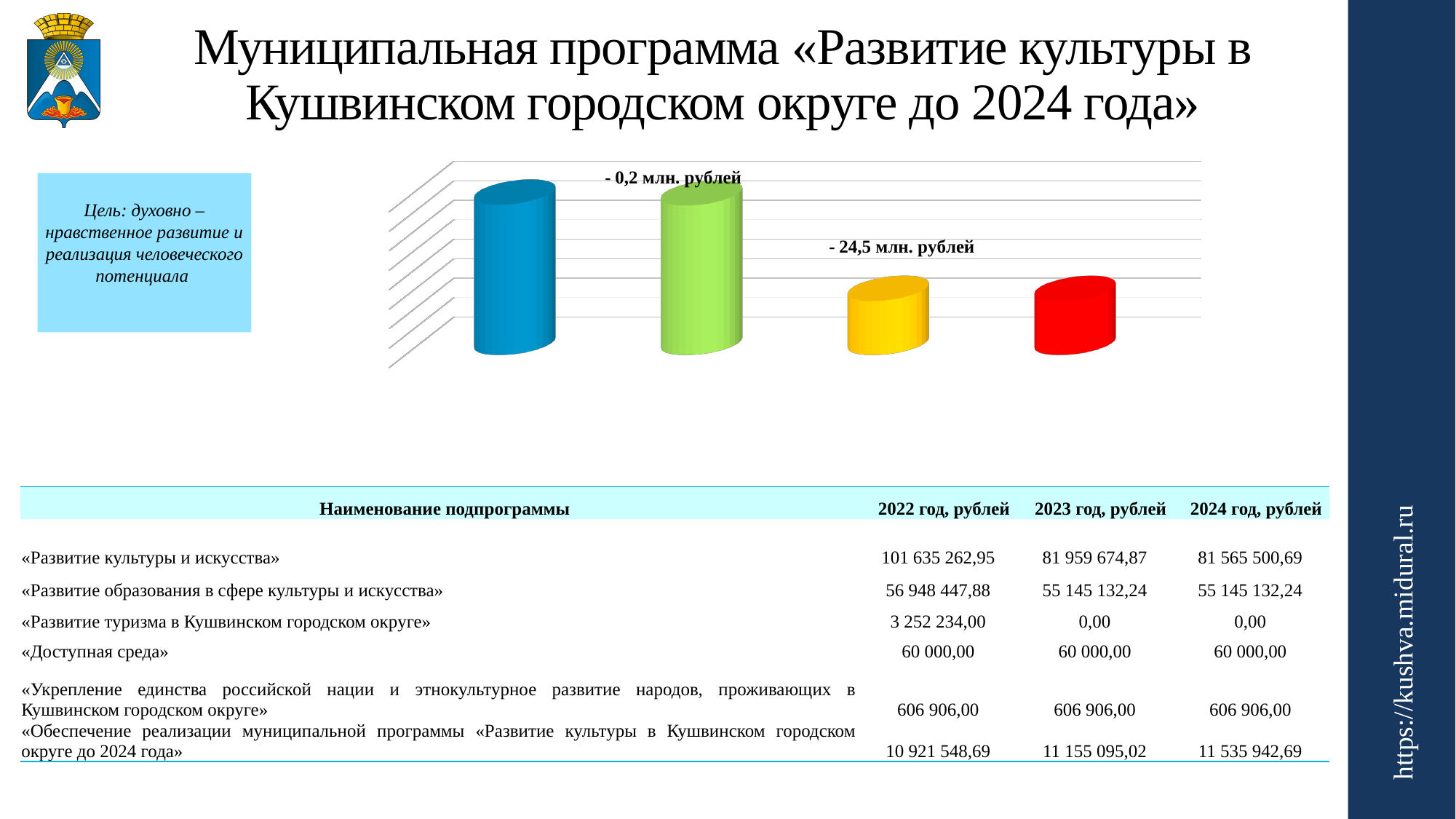
How many bars does the chart contain? 4 How many bars are taller than the yellow bar? 2 Which is taller, the blue bar or the yellow bar? the blue bar What text annotation is placed above the yellow bar? - 24,5 млн. рублей What text annotation is placed above the green bar? - 0,2 млн. рублей What kind of chart is shown on the slide? bar chart Which is taller, the green bar or the red bar? the green bar Which is shorter, the blue bar or the red bar? the red bar